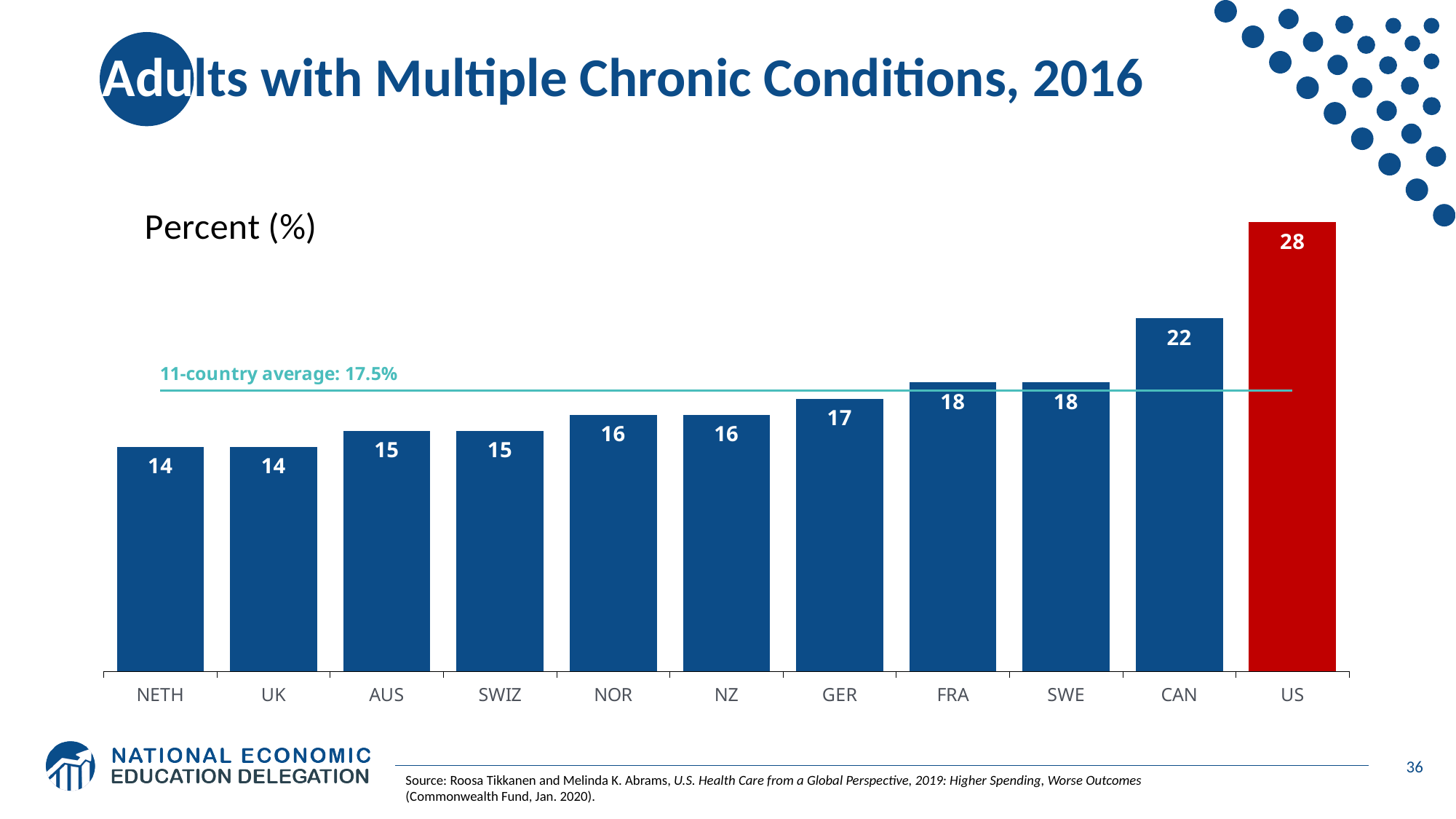
Which is larger, the value for Norway (NOR) or the value for Australia (AUS)? NOR Which country has the highest value? US What is the value for Germany (GER)? 17 How many countries are shown on the chart? 11 What is the value for the US? 28 What is the difference between the value for France (FRA) and the value for the Netherlands (NETH)? 4 What is the difference between the US value and the Canada (CAN) value? 6 What is the value for Canada (CAN)? 22 What is the 11-country average shown on the chart? 17.5% Do the values rise or fall from left to right along the x axis? Rise What kind of chart is shown on the slide? Bar chart Which country's bar is coloured red? US